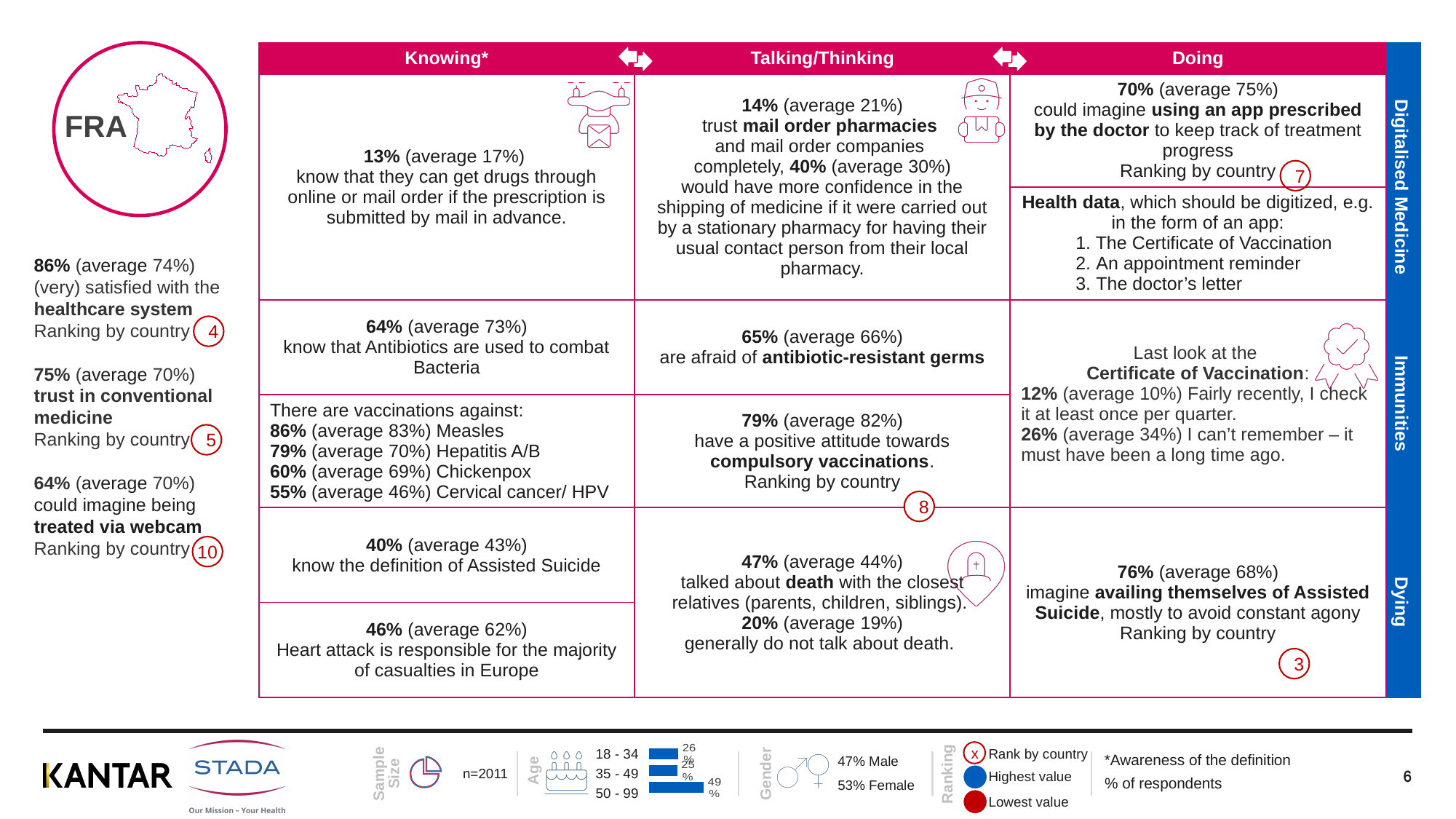
In the Age bar chart, what is the value for the 50 - 99 age group? 49% In the Age bar chart, which age group has the longest bar? 50 - 99 How many age groups are shown in the Age bar chart? 3 What colour are the bars in the Age bar chart? blue What kind of chart is the Age chart at the bottom of the slide? bar chart In the Age bar chart, which age group has the highest value? 50 - 99 In the Age bar chart, is the value for 50 - 99 larger than the value for 18 - 34? Yes What are the three age group labels in the Age bar chart? 18 - 34, 35 - 49, 50 - 99